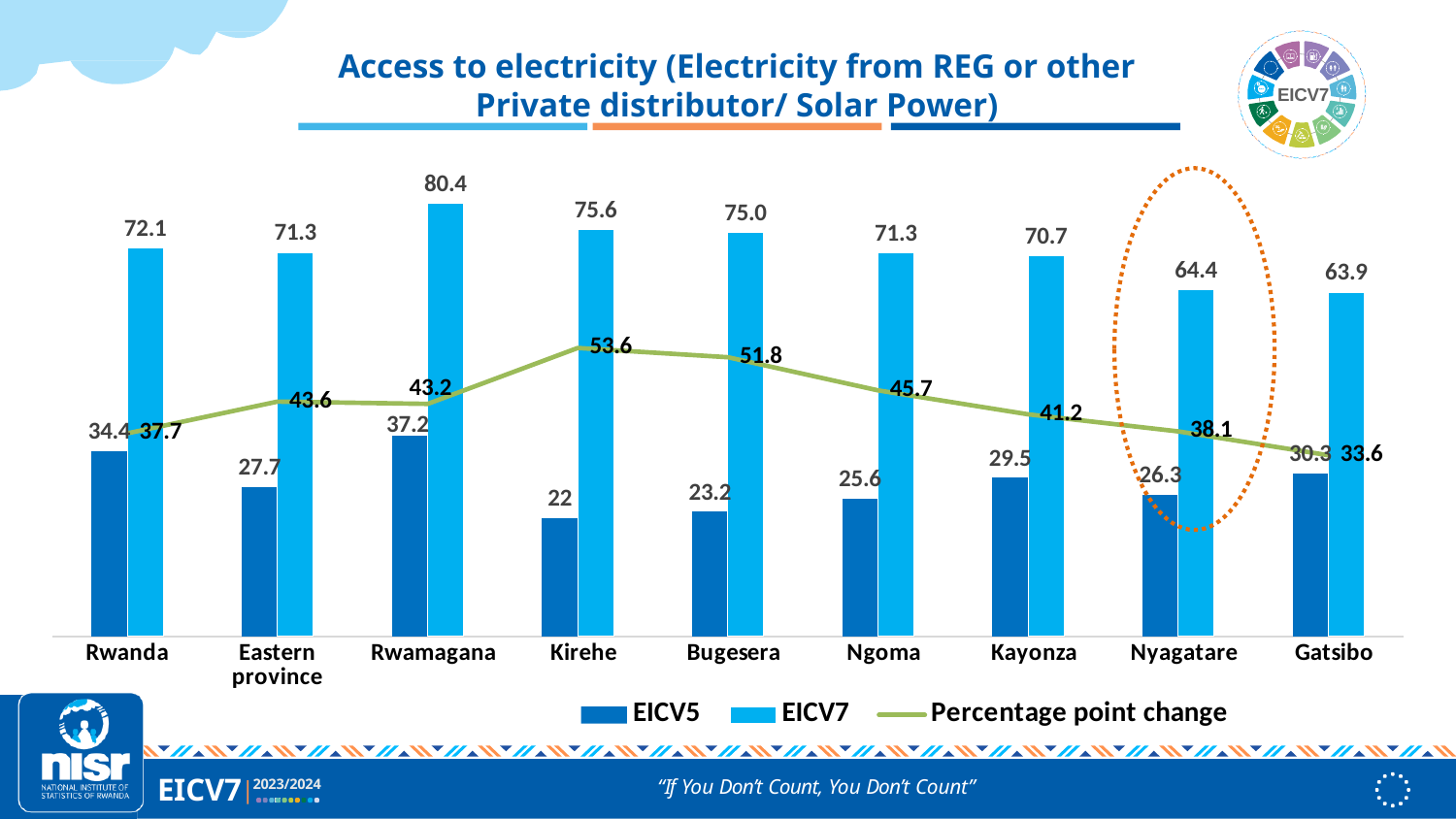
Which category has the highest percentage point change? Kirehe What is the EICV7 value for Rwamagana? 80.4 What is the difference between the EICV7 and EICV5 values for Rwanda? 37.7 What is the EICV5 value for Kirehe? 22 How many categories are shown on the x axis? 9 What is the percentage point change for Kirehe? 53.6 Which category has the lowest EICV7 value? Gatsibo What kind of chart is this? Bar chart with a line Which category is highlighted with a dotted orange circle? Nyagatare How many series does the legend list? 3 Which has a larger EICV7 value, Kirehe or Bugesera? Kirehe Which category has the highest EICV7 value? Rwamagana